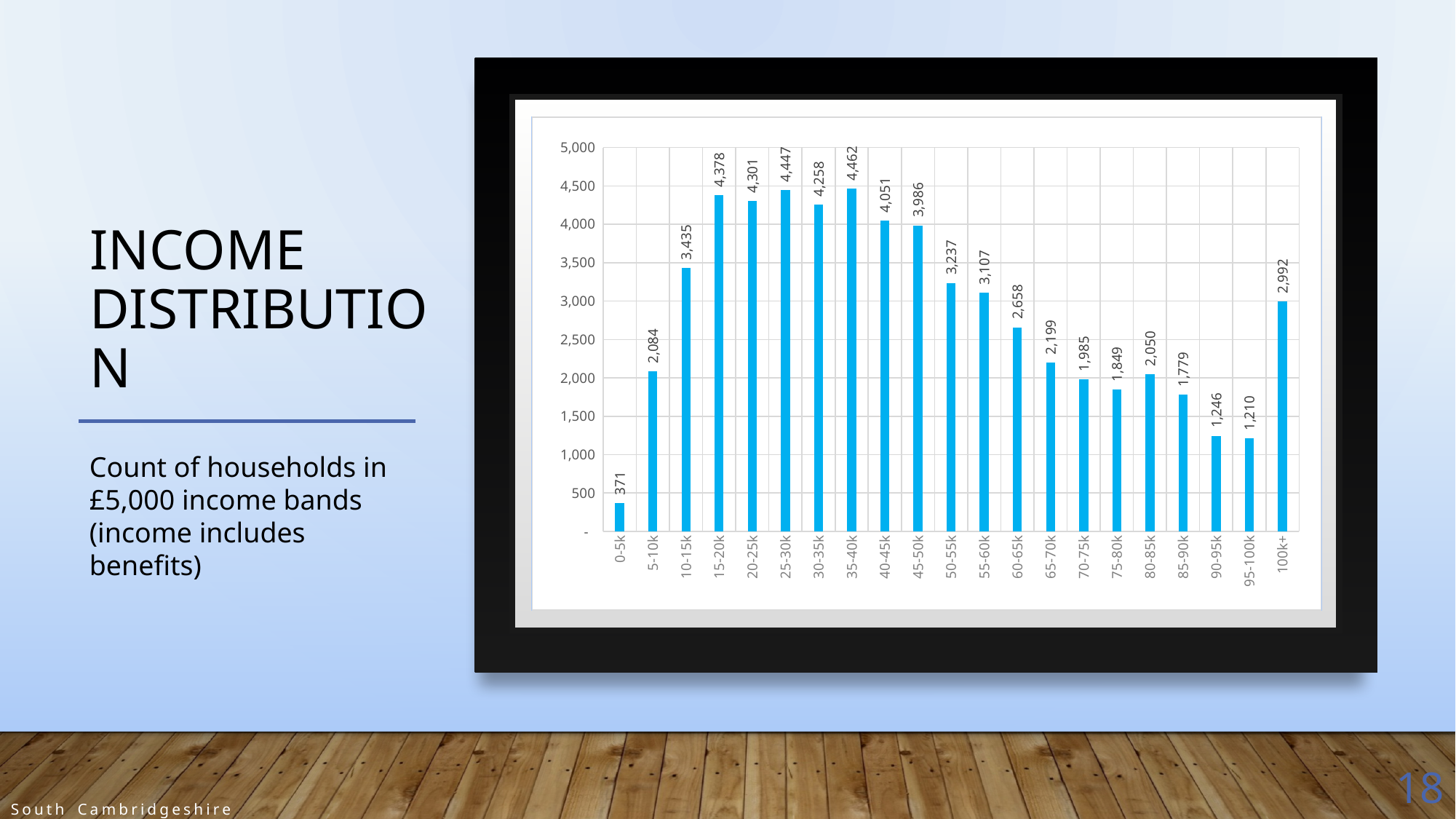
How many income bands are shown on the x axis? 21 What is the count of households in the 0-5k income band? 371 What is the count of households in the 100k+ income band? 2,992 What is the difference between the counts for the 100k+ band and the 95-100k band? 1,782 Which income band has the lowest count of households? 0-5k Which income band has the highest count of households? 35-40k What is the count of households in the 50-55k income band? 3,237 Do the values rise or fall from the 35-40k band to the 95-100k band? Fall Is the value for the 60-65k band greater or less than 2,500? greater Which has a higher count of households, the 75-80k band or the 80-85k band? 80-85k What is the difference between the counts for the 15-20k band and the 10-15k band? 943 What kind of chart is shown on the slide? Bar chart